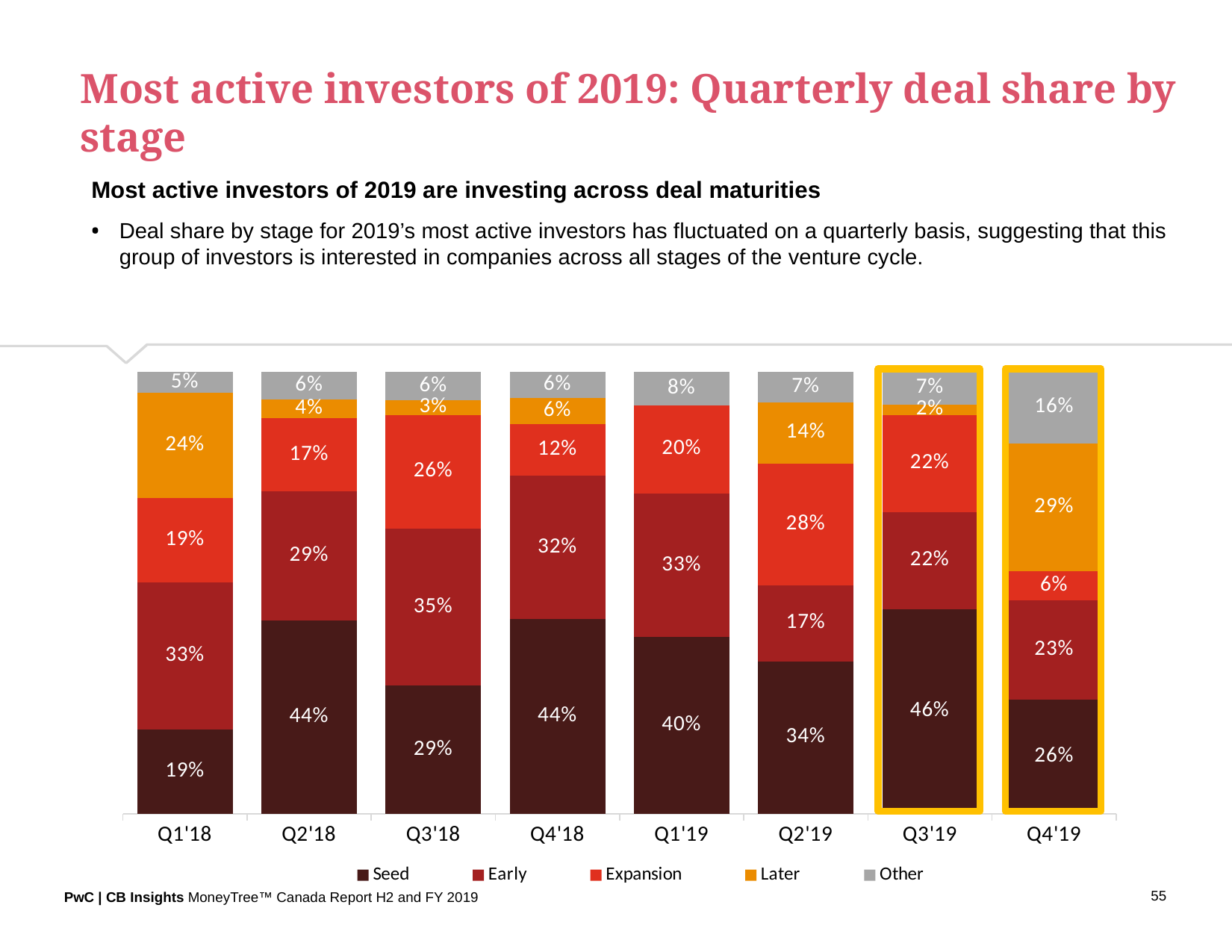
What is the Later share for Q4'19? 29% What kind of chart is shown on the slide? Stacked bar chart What is the Other share for Q4'19? 16% How many series does the legend list? 5 Which two quarters are highlighted with a yellow outline? Q3'19 and Q4'19 What is the Seed share for Q3'19? 46% How many quarters are shown on the x axis? 8 In which quarter is the Seed share lowest? Q1'18 What is the difference between the Seed share in Q3'19 and the Seed share in Q4'19? 20% What is the Expansion share for Q2'19? 28% Which is larger, the Early share in Q3'18 or the Early share in Q2'19? Q3'18 In which quarter is the Seed share highest? Q3'19